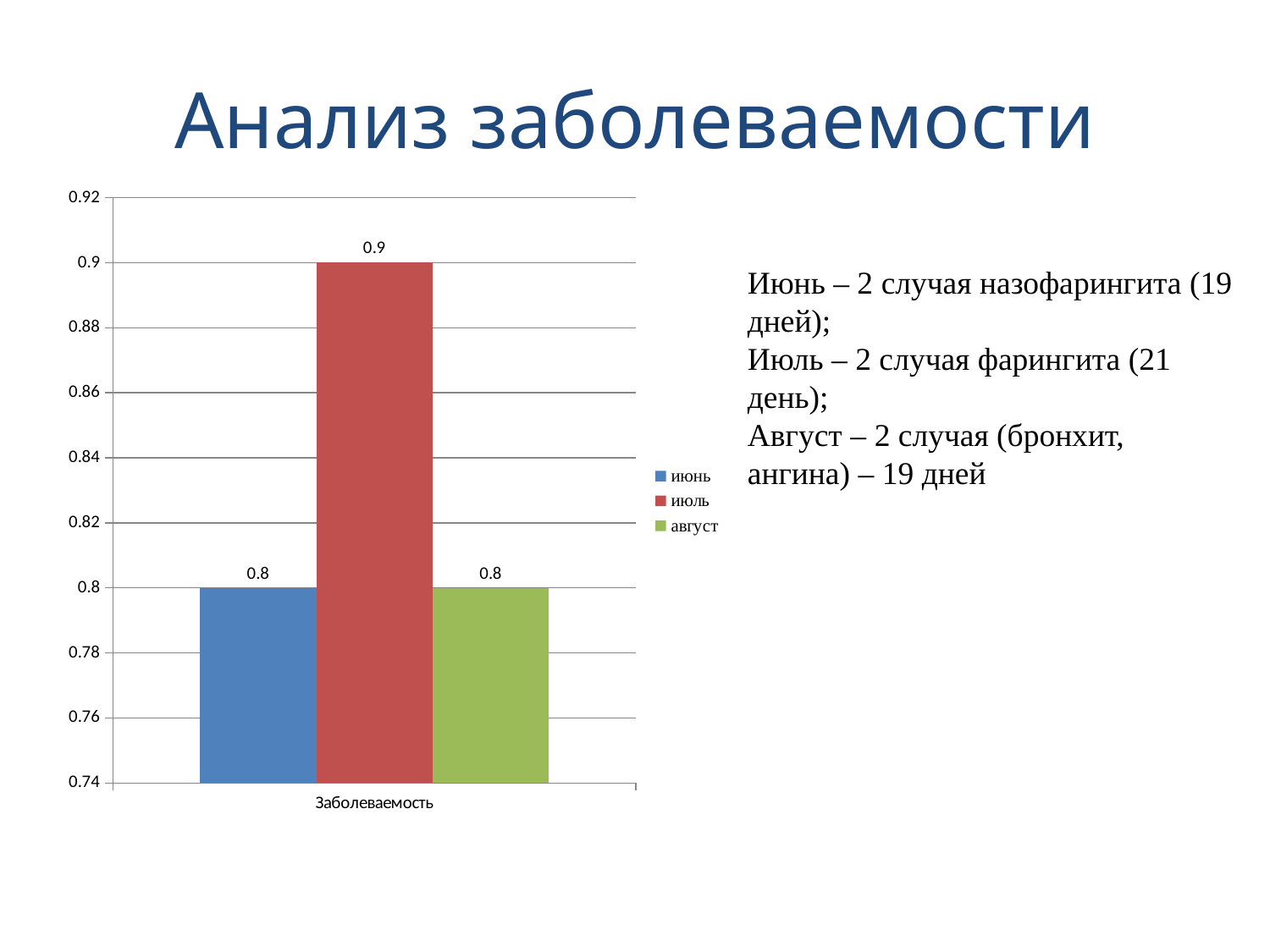
What is the value for июнь in the chart? 0.8 Is the value for июль greater or less than 0.86? greater What is the value for август in the chart? 0.8 Which is larger, the value for июль or the value for август? июль What kind of chart is shown on the slide? bar chart Which series has the highest value in the chart? июль What is the value for июль in the chart? 0.9 How many series does the legend list? 3 What is the category label on the x axis of the chart? Заболеваемость What is the difference between the values for июль and июнь? 0.1 What colour is the bar for июль? red Is the value for июнь greater or less than 0.84? less